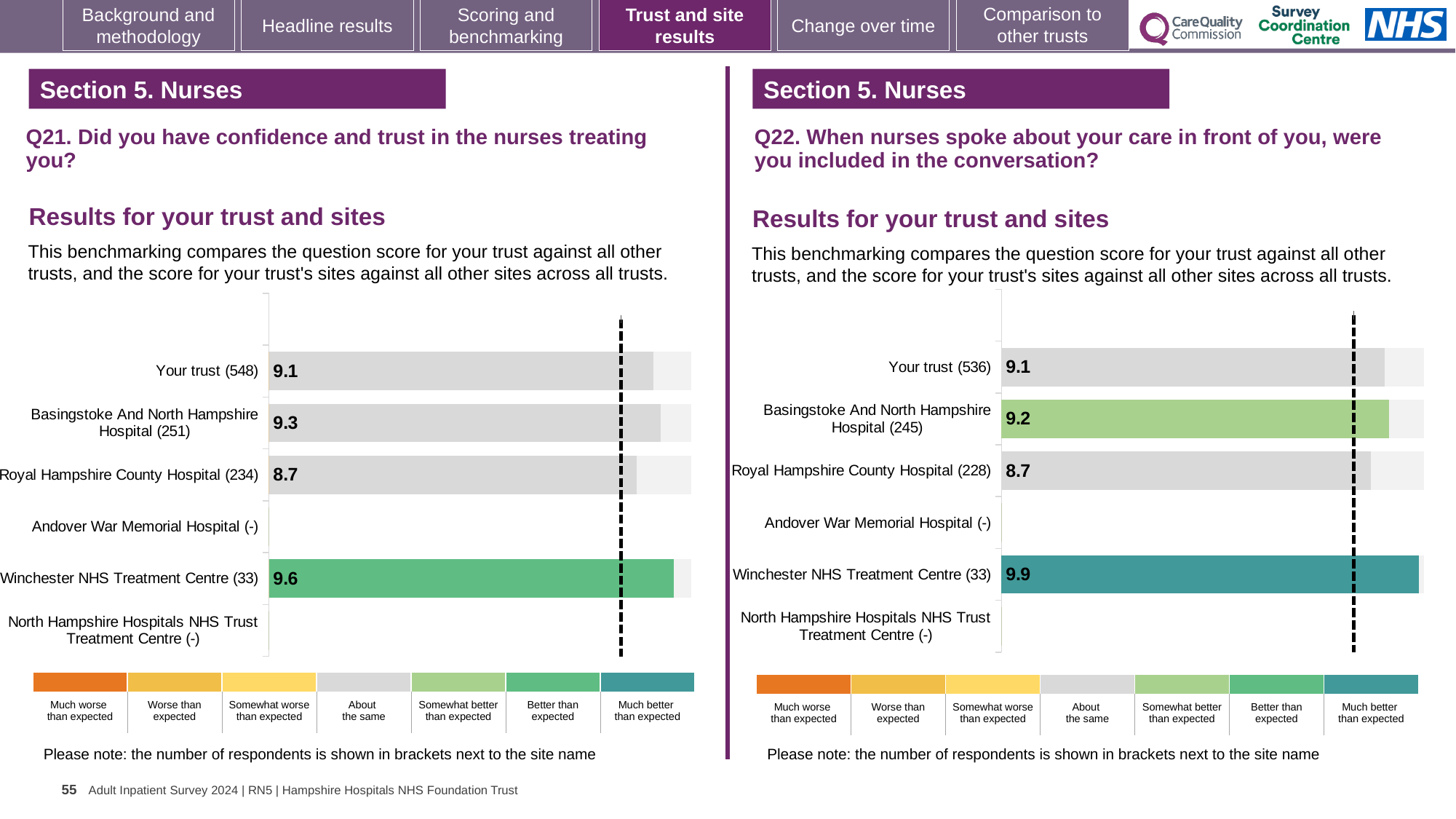
In the Q21 chart, which site has the lowest score? Royal Hampshire County Hospital (234) In the Q21 chart, how many sites have a score shown as a bar? 4 In the Q21 chart, what is the score for Winchester NHS Treatment Centre (33)? 9.6 In the Q22 chart, what is the difference between the scores for Winchester NHS Treatment Centre (33) and Your trust (536)? 0.8 In the Q22 chart, which benchmark category does the colour of the Winchester NHS Treatment Centre (33) bar correspond to? Much better than expected In the Q21 chart, what is the score for Your trust (548)? 9.1 In the Q22 chart, what is the score for Basingstoke And North Hampshire Hospital (245)? 9.2 In the Q22 chart, which has the higher score: Your trust (536) or Basingstoke And North Hampshire Hospital (245)? Basingstoke And North Hampshire Hospital (245) In the Q22 chart, what is the score for Royal Hampshire County Hospital (228)? 8.7 In the Q21 chart, what is the difference between the scores for Basingstoke And North Hampshire Hospital (251) and Royal Hampshire County Hospital (234)? 0.6 What type of chart is used for the Q22 results? Bar chart In the Q22 chart, which site has the highest score? Winchester NHS Treatment Centre (33)